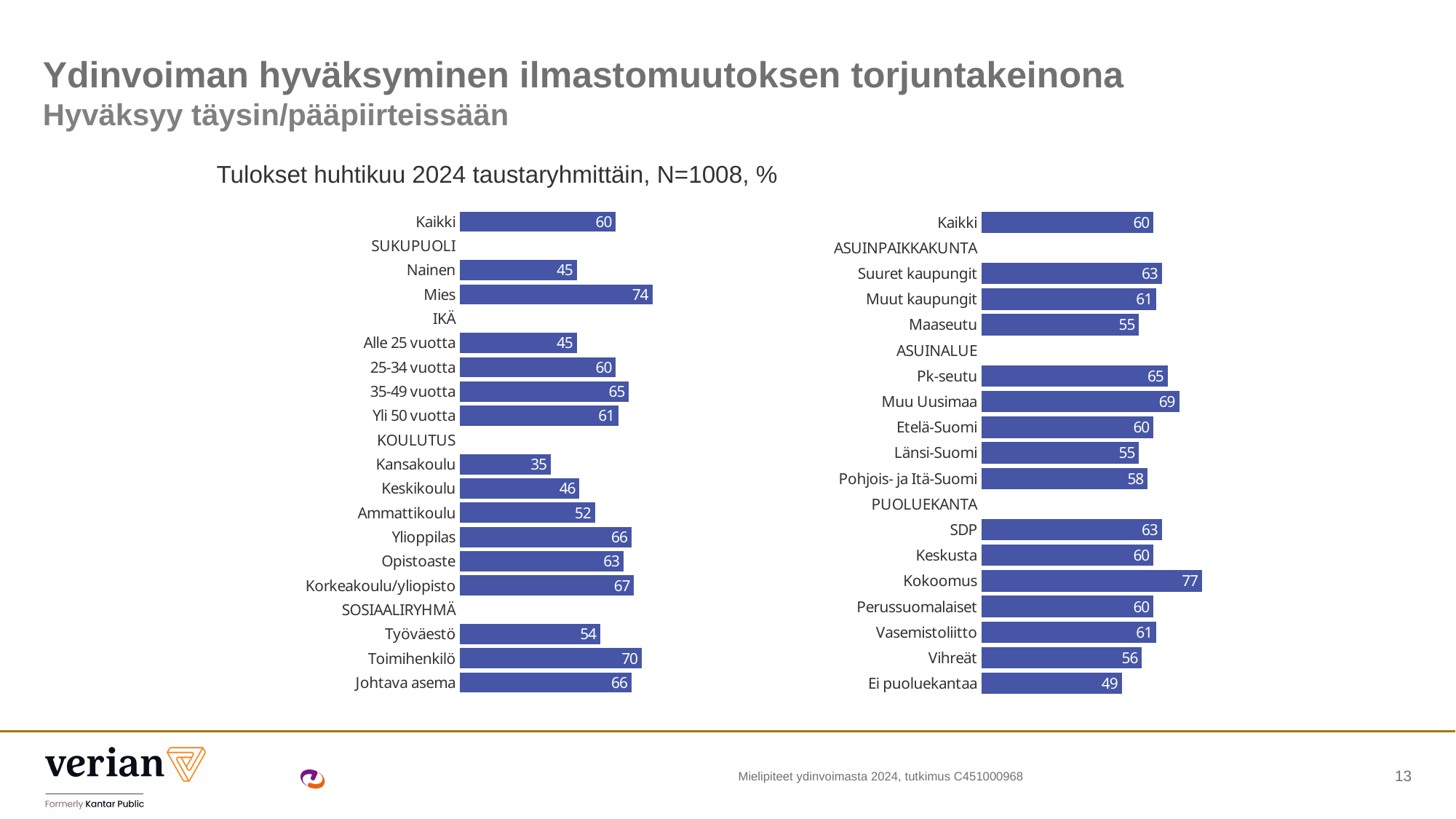
In the left chart, what is the value for Mies? 74 In the left chart, which category has the lowest value? Kansakoulu In the right chart, what is the value for Maaseutu? 55 In the right chart, what is the value for Kaikki? 60 In the right chart, which category has the highest value? Kokoomus In the left chart, what is the value for Kansakoulu? 35 In the right chart, what is the value for Kokoomus? 77 In the right chart, which is larger, the value for Muu Uusimaa or the value for Länsi-Suomi? Muu Uusimaa In the left chart, what is the difference between the values for Mies and Nainen? 29 What kind of chart is shown on the slide? Bar chart In the right chart, what is the difference between the values for Kokoomus and Ei puoluekantaa? 28 In the left chart, which is larger, the value for Toimihenkilö or the value for Työväestö? Toimihenkilö